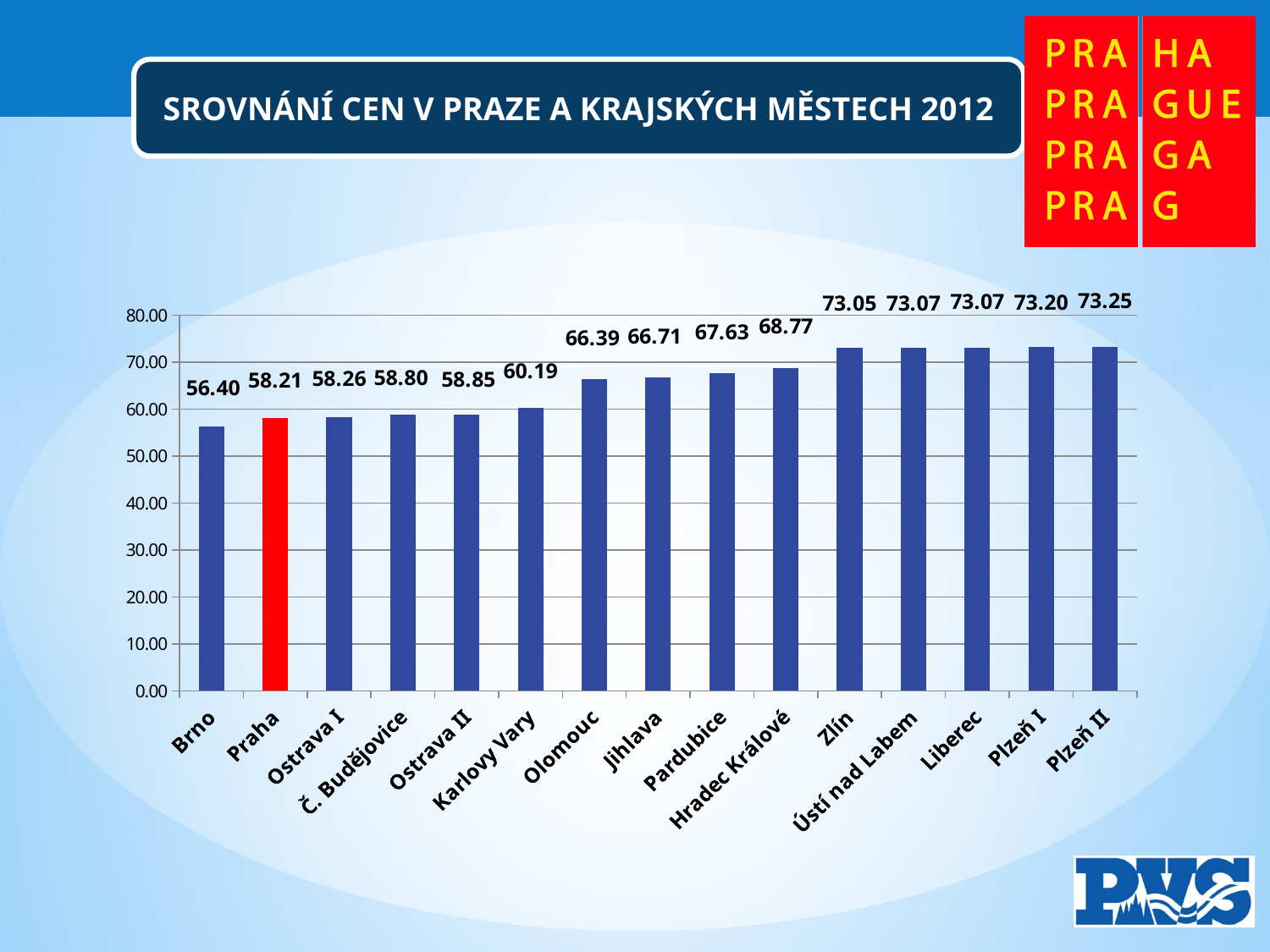
What is the value for Karlovy Vary? 60.19 Which bar is coloured red instead of blue? Praha What is the value for Hradec Králové? 68.77 What kind of chart is shown on the slide? bar chart What is the difference between the values for Praha and Brno? 1.81 Which is larger, the value for Olomouc or the value for Zlín? Zlín What is the value for Praha? 58.21 Is the value for Jihlava greater or less than 70.00? less How many cities are shown on the chart? 15 Which city has the lowest value? Brno What is the difference between the values for Plzeň II and Brno? 16.85 Which city has the highest value? Plzeň II